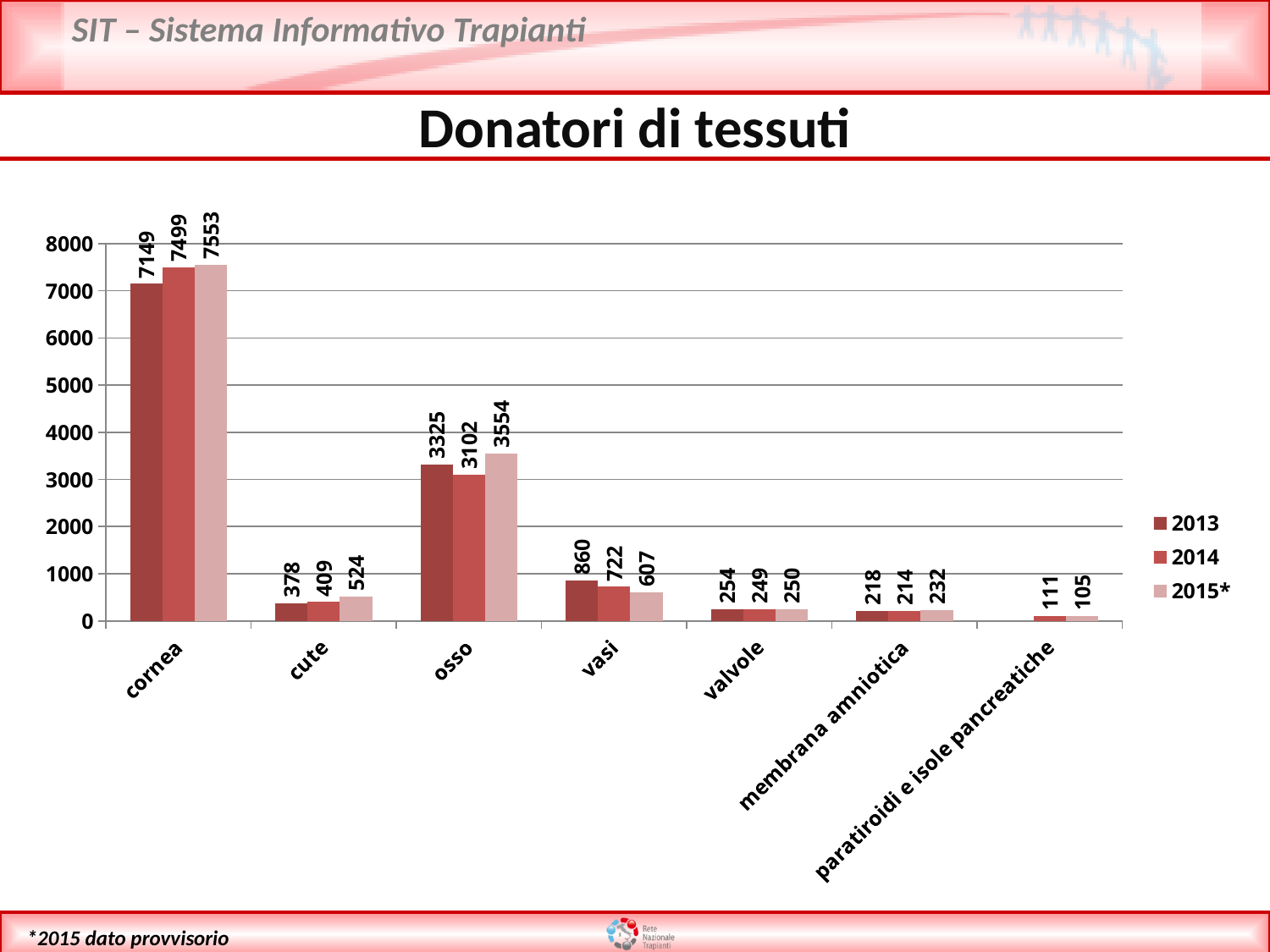
How many categories are shown on the x axis? 7 How many series does the legend list? 3 What is the value for vasi in 2013? 860 What is the value for osso in 2014? 3102 What is the value for cute in 2015*? 524 Which category has the highest value in 2013? cornea Which category has the lowest value in 2015*? paratiroidi e isole pancreatiche What is the difference between the 2015* and 2013 values for cornea? 404 Which is larger for osso: the 2013 value or the 2014 value? 2013 Is the value for vasi in 2013 greater or less than 1000? less What is the value for cornea in 2015*? 7553 What kind of chart is shown on the slide? bar chart